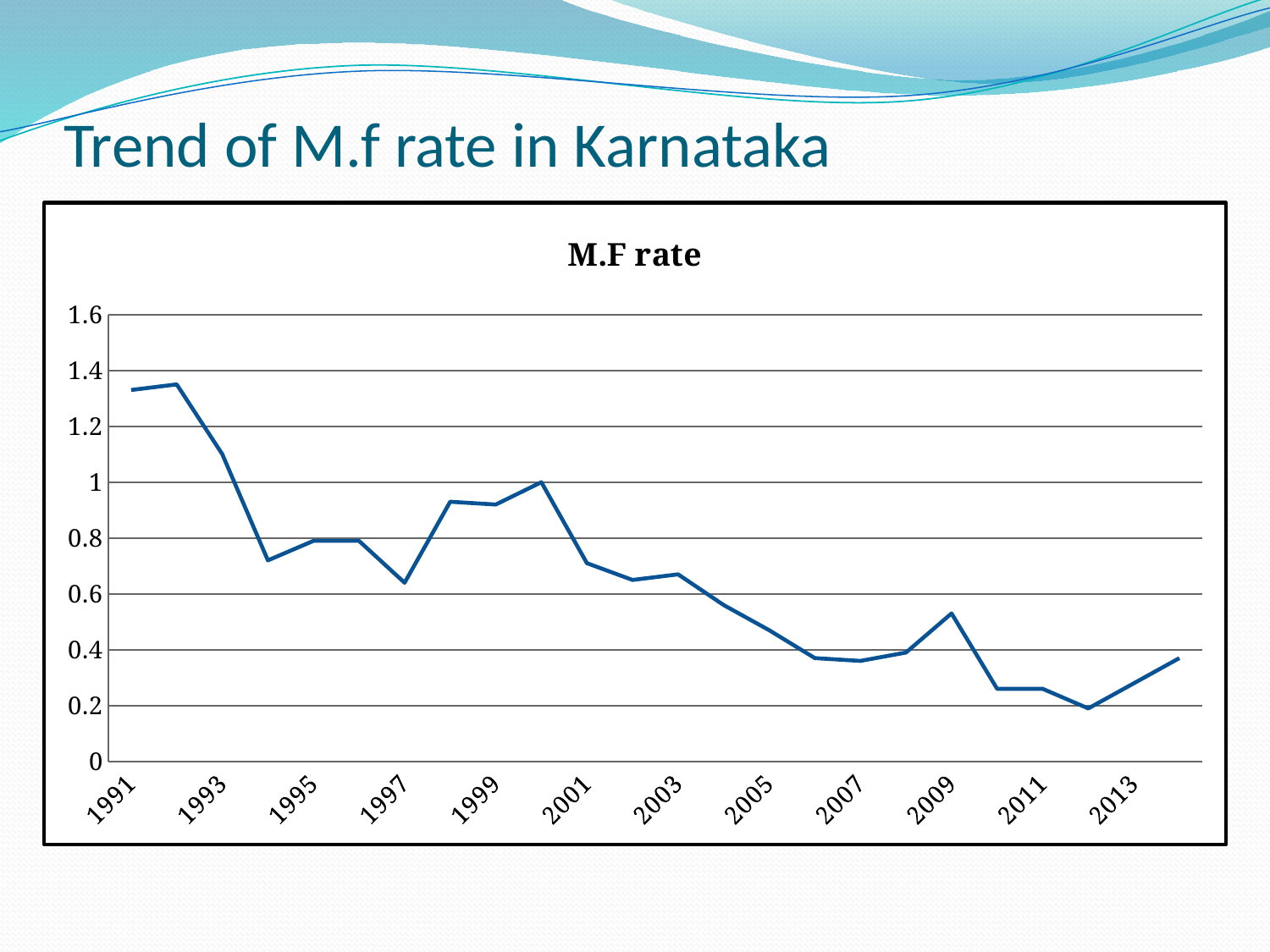
How many year labels are shown on the x axis? 12 Overall, does the M.F rate rise or fall from 1991 to 2013? fall Is the value for 2011 greater or less than 0.4? less What kind of chart is shown on the slide? line chart Which year has the higher M.F rate, 1991 or 2013? 1991 Is the value for 2007 greater or less than 0.4? less Is the value for 1997 greater or less than 0.8? less What is the title of the chart? M.F rate Which year has the higher M.F rate, 1999 or 2005? 1999